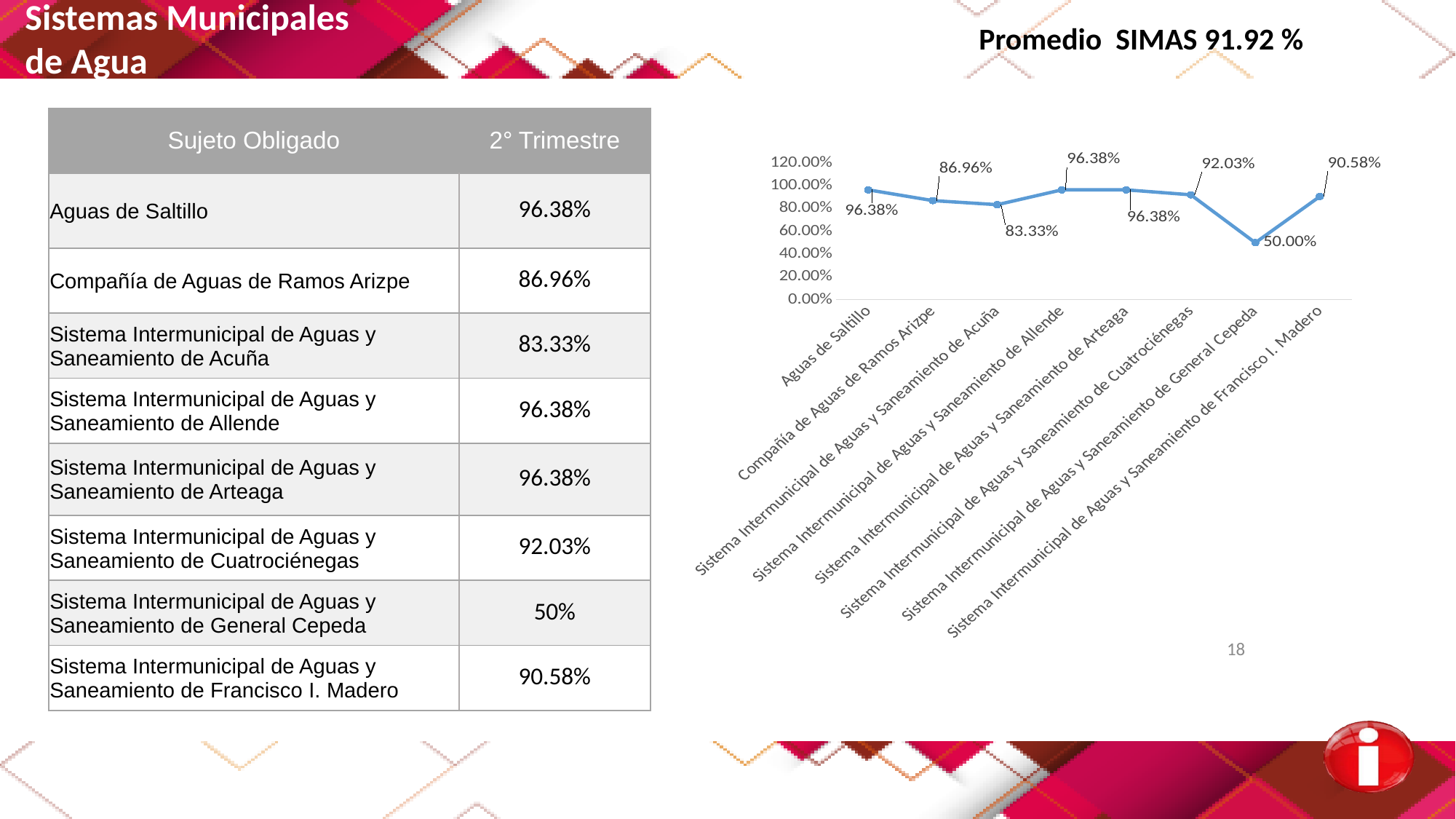
What is the value plotted for Sistema Intermunicipal de Aguas y Saneamiento de Acuña in the chart? 83.33% Which category has the lowest value in the chart? Sistema Intermunicipal de Aguas y Saneamiento de General Cepeda What is the value plotted for Sistema Intermunicipal de Aguas y Saneamiento de General Cepeda in the chart? 50.00% What is the difference between the values for Sistema Intermunicipal de Aguas y Saneamiento de Cuatrociénegas and Sistema Intermunicipal de Aguas y Saneamiento de General Cepeda in the chart? 42.03% Is the value for Sistema Intermunicipal de Aguas y Saneamiento de General Cepeda in the chart greater or less than 80.00%? less What is the highest tick value shown on the y axis of the chart? 120.00% What is the value plotted for Compañía de Aguas de Ramos Arizpe in the chart? 86.96% What is the value plotted for Sistema Intermunicipal de Aguas y Saneamiento de Francisco I. Madero in the chart? 90.58% What is the value plotted for Aguas de Saltillo in the chart? 96.38% Which has a larger value in the chart, Compañía de Aguas de Ramos Arizpe or Sistema Intermunicipal de Aguas y Saneamiento de Acuña? Compañía de Aguas de Ramos Arizpe What kind of chart is shown on the slide? line chart How many categories are plotted on the x axis of the chart? 8